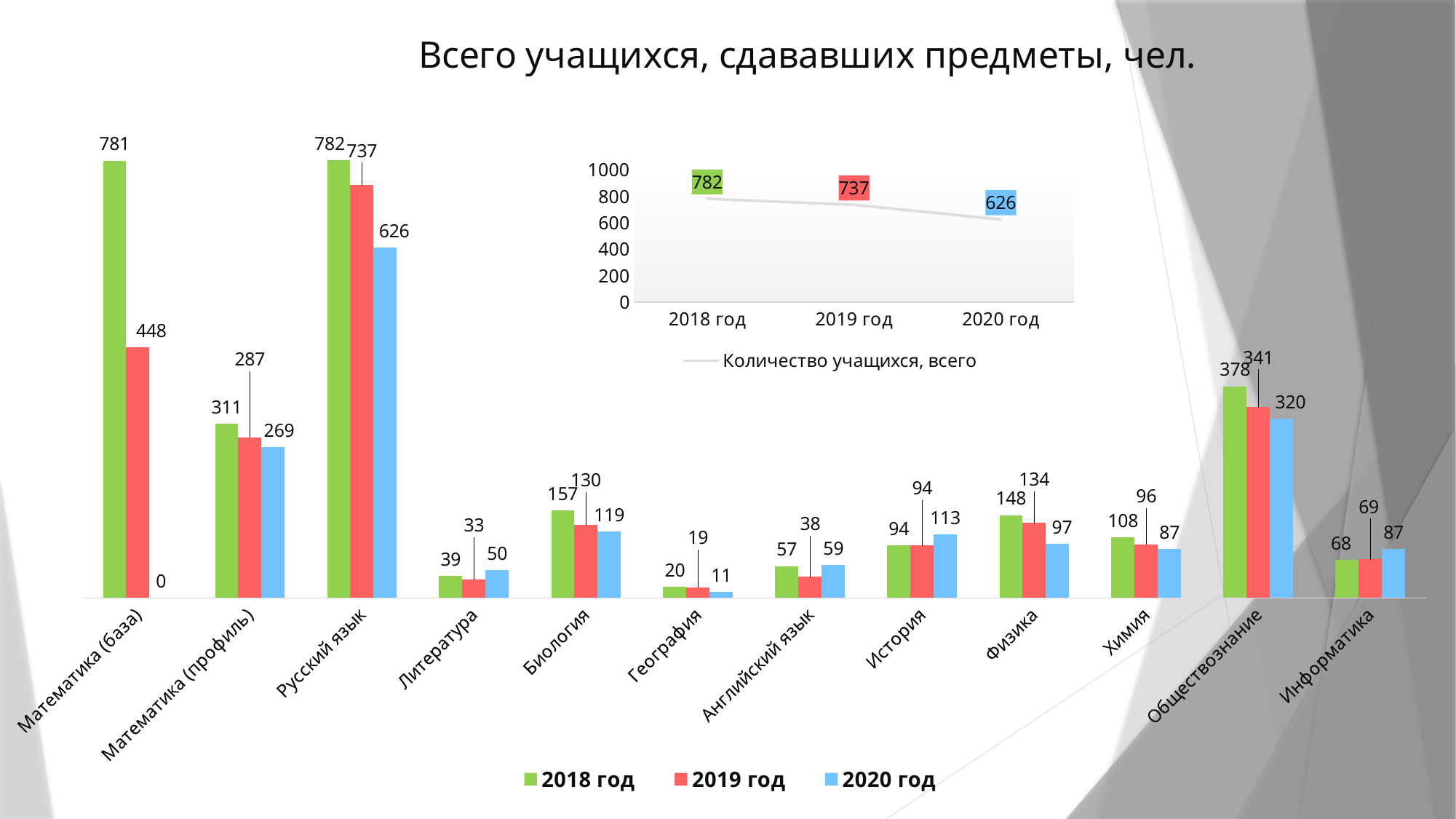
What kind of chart is the inset chart 'Количество учащихся, всего'? line chart How many series does the legend of the bar chart 'Всего учащихся, сдававших предметы, чел.' list? 3 In the bar chart 'Всего учащихся, сдававших предметы, чел.', what is the value for Русский язык in 2018 год? 782 In the inset line chart 'Количество учащихся, всего', do the values rise or fall from 2018 год to 2020 год? fall How many subjects are shown on the x axis of the bar chart 'Всего учащихся, сдававших предметы, чел.'? 12 In the bar chart 'Всего учащихся, сдававших предметы, чел.', what is the value for Математика (база) in 2020 год? 0 In the bar chart 'Всего учащихся, сдававших предметы, чел.', which subject has the lowest value for 2020 год? Математика (база) In the bar chart 'Всего учащихся, сдававших предметы, чел.', which is larger for Физика: the 2018 год value or the 2020 год value? 2018 год In the bar chart 'Всего учащихся, сдававших предметы, чел.', what is the difference between the 2018 год and 2019 год values for Математика (база)? 333 In the bar chart 'Всего учащихся, сдававших предметы, чел.', what is the value for Обществознание in 2020 год? 320 In the inset line chart 'Количество учащихся, всего', what is the value for 2020 год? 626 In the bar chart 'Всего учащихся, сдававших предметы, чел.', which subject has the highest value for 2019 год? Русский язык